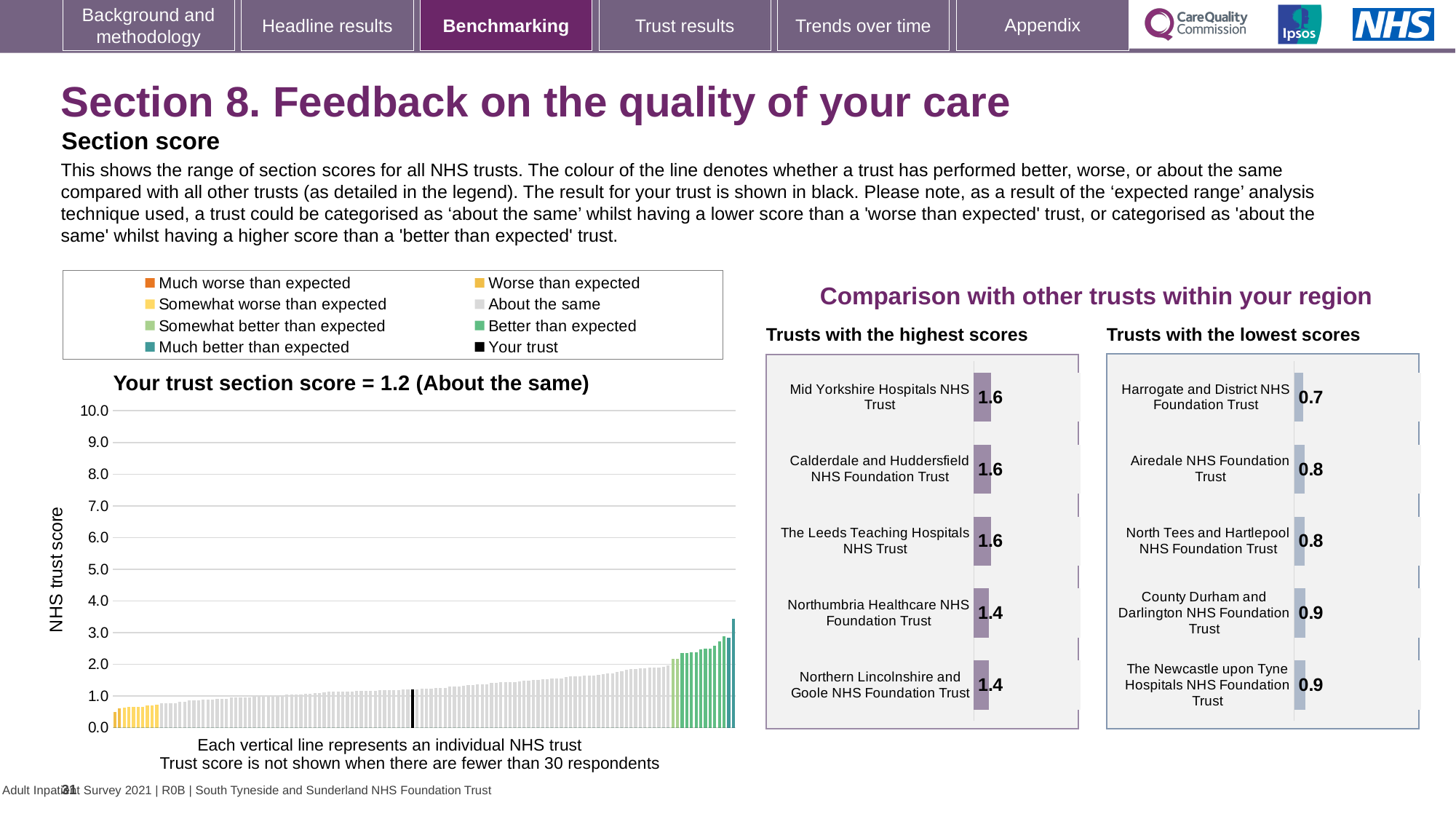
On the 'Your trust section score' chart, what kind of chart is shown? bar chart On the 'Trusts with the highest scores' chart, what is the score for Northumbria Healthcare NHS Foundation Trust? 1.4 On the 'Trusts with the lowest scores' chart, which is larger: the score for County Durham and Darlington NHS Foundation Trust or the score for Harrogate and District NHS Foundation Trust? County Durham and Darlington NHS Foundation Trust On the 'Your trust section score' chart, what is the section score for your trust? 1.2 How many entries does the legend above the 'Your trust section score' chart list? 8 On the 'Trusts with the highest scores' chart, what is the difference between the score for Mid Yorkshire Hospitals NHS Trust and the score for Northern Lincolnshire and Goole NHS Foundation Trust? 0.2 On the 'Trusts with the lowest scores' chart, which trust has the lowest score? Harrogate and District NHS Foundation Trust On the 'Trusts with the highest scores' chart, how many trusts are listed? 5 On the 'Your trust section score' chart, is the value of the tallest bar greater or less than 3.0? greater On the 'Your trust section score' chart, what is the highest value shown on the y axis? 10.0 On the 'Your trust section score' chart, do the trust scores rise or fall from left to right along the x axis? rise On the 'Trusts with the lowest scores' chart, what is the score for Airedale NHS Foundation Trust? 0.8